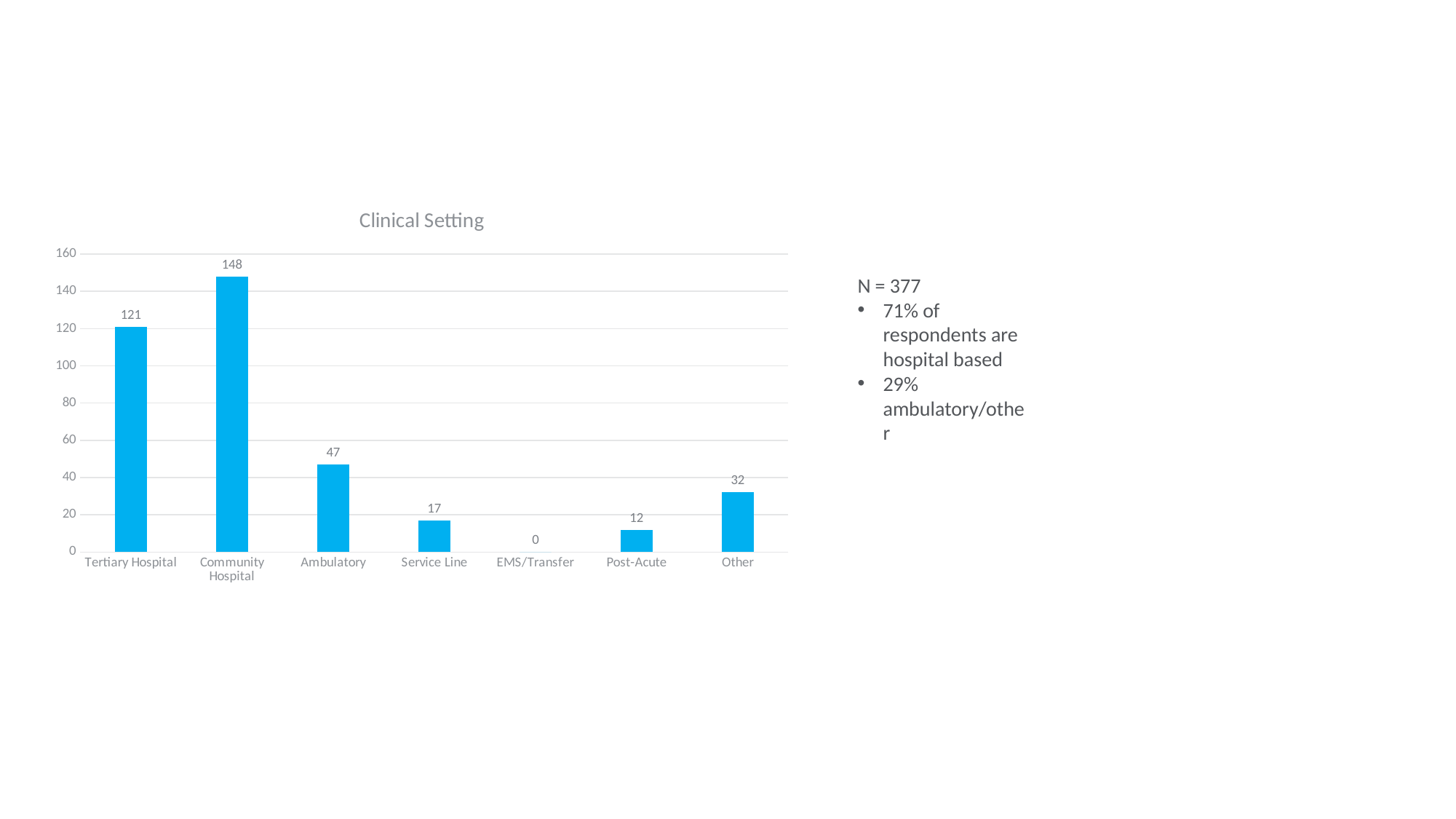
What is the difference between Community Hospital and Tertiary Hospital? 27 What is the title of the chart? Clinical Setting Which category has the highest value? Community Hospital What kind of chart is this? bar chart Which is larger, Other or Service Line? Other Which category has the lowest value? EMS/Transfer What is the value for EMS/Transfer? 0 What is the value for Post-Acute? 12 What is the value for Community Hospital? 148 Is the value for Tertiary Hospital greater or less than 100? greater What is the value for Ambulatory? 47 How many categories are shown on the x axis? 7